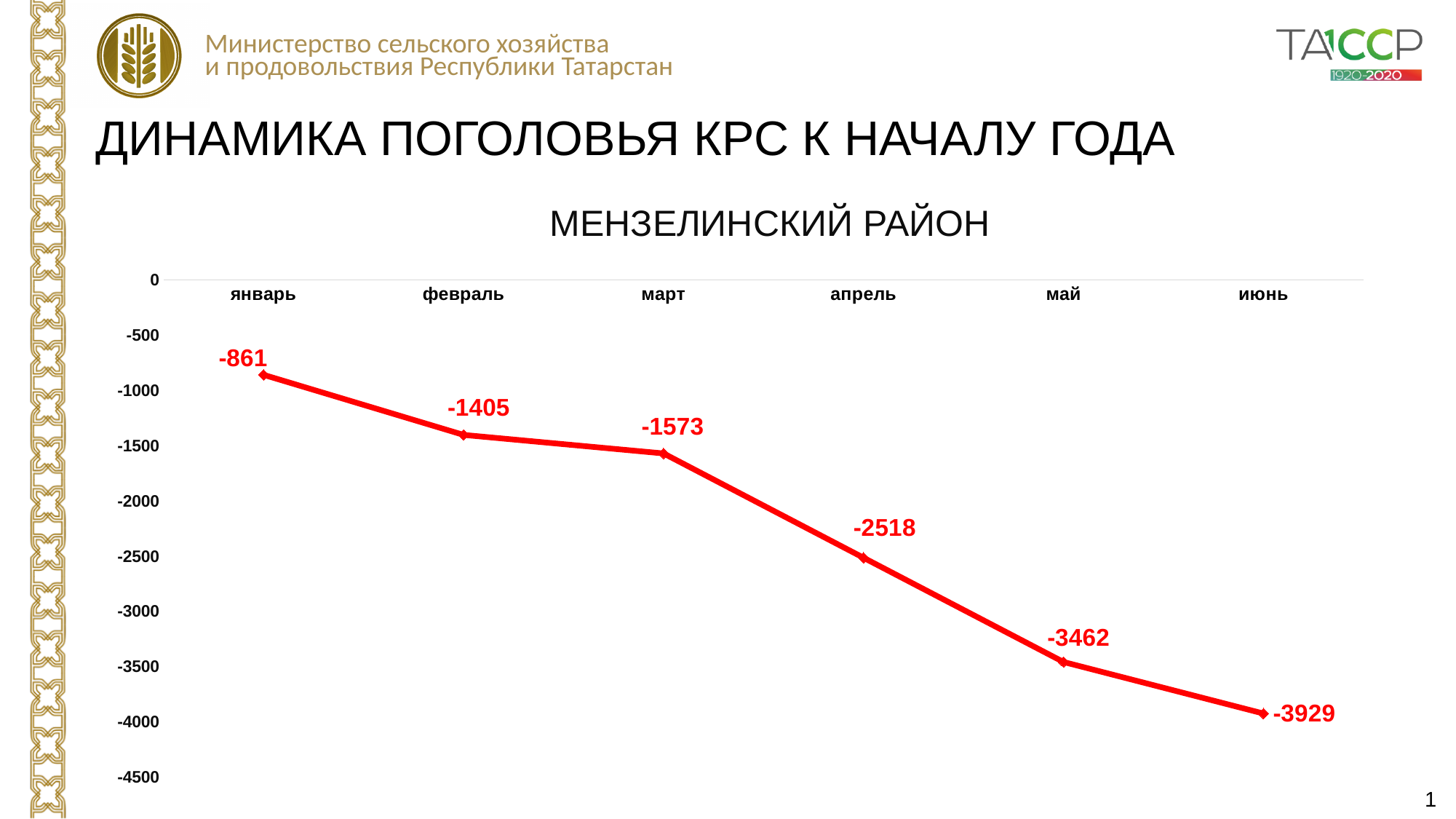
Which month has the highest value? январь What is the value for июнь? -3929 What is the value for январь? -861 What is the value for апрель? -2518 What kind of chart is shown on the slide? line chart Do the values rise or fall from январь to июнь? fall What is the difference between the values for май and апрель? 944 How many months are plotted on the chart? 6 Is the value for май greater or less than -3000? less What is the title of the chart? МЕНЗЕЛИНСКИЙ РАЙОН Which month has the lowest value? июнь Which is larger, the value for февраль or the value for март? февраль